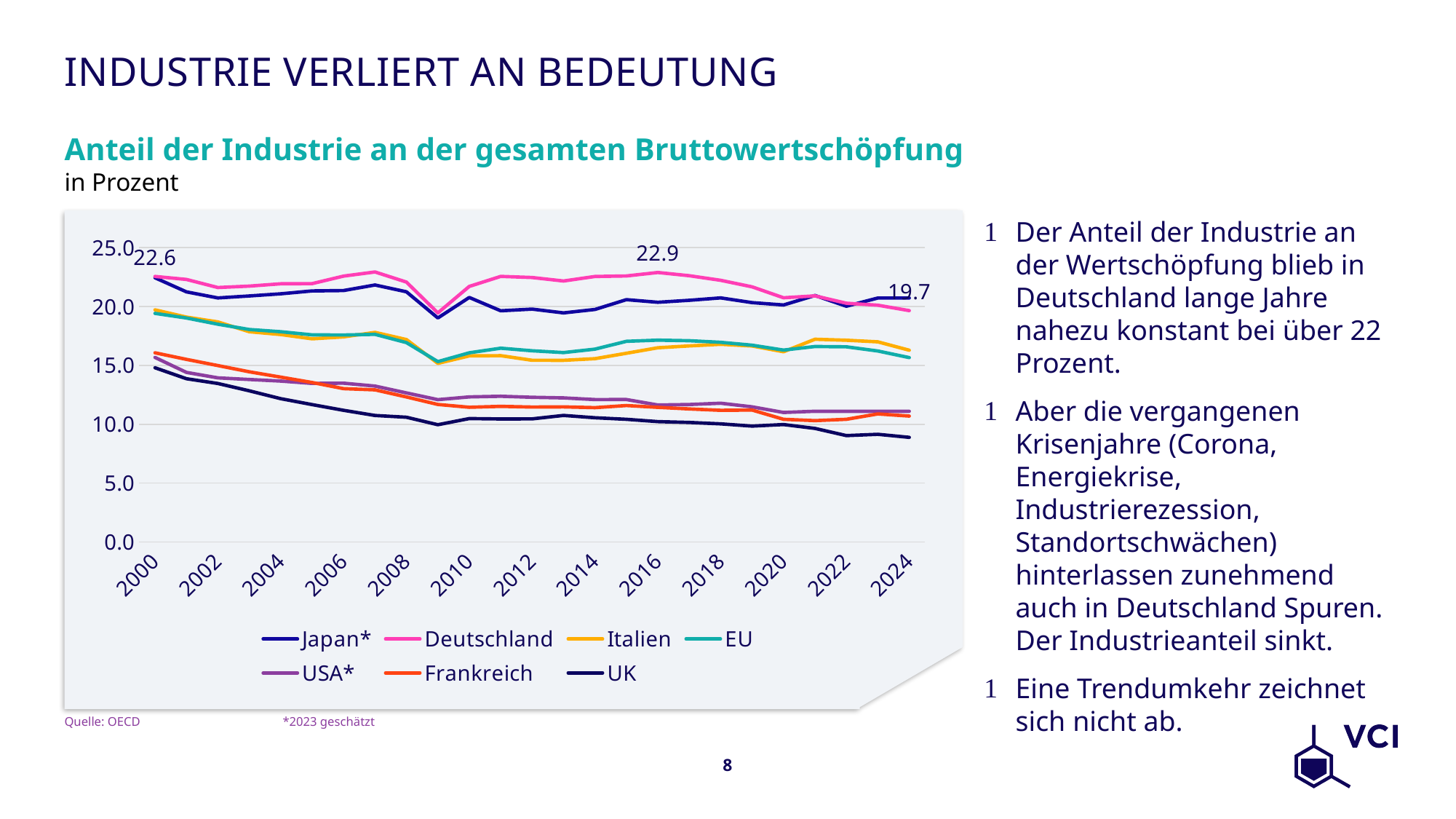
What kind of chart is shown on the slide? line chart What is the value for Deutschland in 2000? 22.6 Is the value for UK in 2024 greater or less than 10.0? less What is the difference between the Deutschland values in 2016 and 2024? 3.2 What is the value for Deutschland in 2016? 22.9 How many series does the legend of the chart list? 7 Does the UK line rise or fall from 2000 to 2024? fall Which series has the lowest value in 2024? UK Which is larger in 2024, the value for Deutschland or the value for UK? Deutschland By how much did the value for Deutschland fall from 2000 to 2024? 2.9 What is the value for Deutschland in 2024? 19.7 Is the value for Italien in 2024 greater or less than 15.0? greater